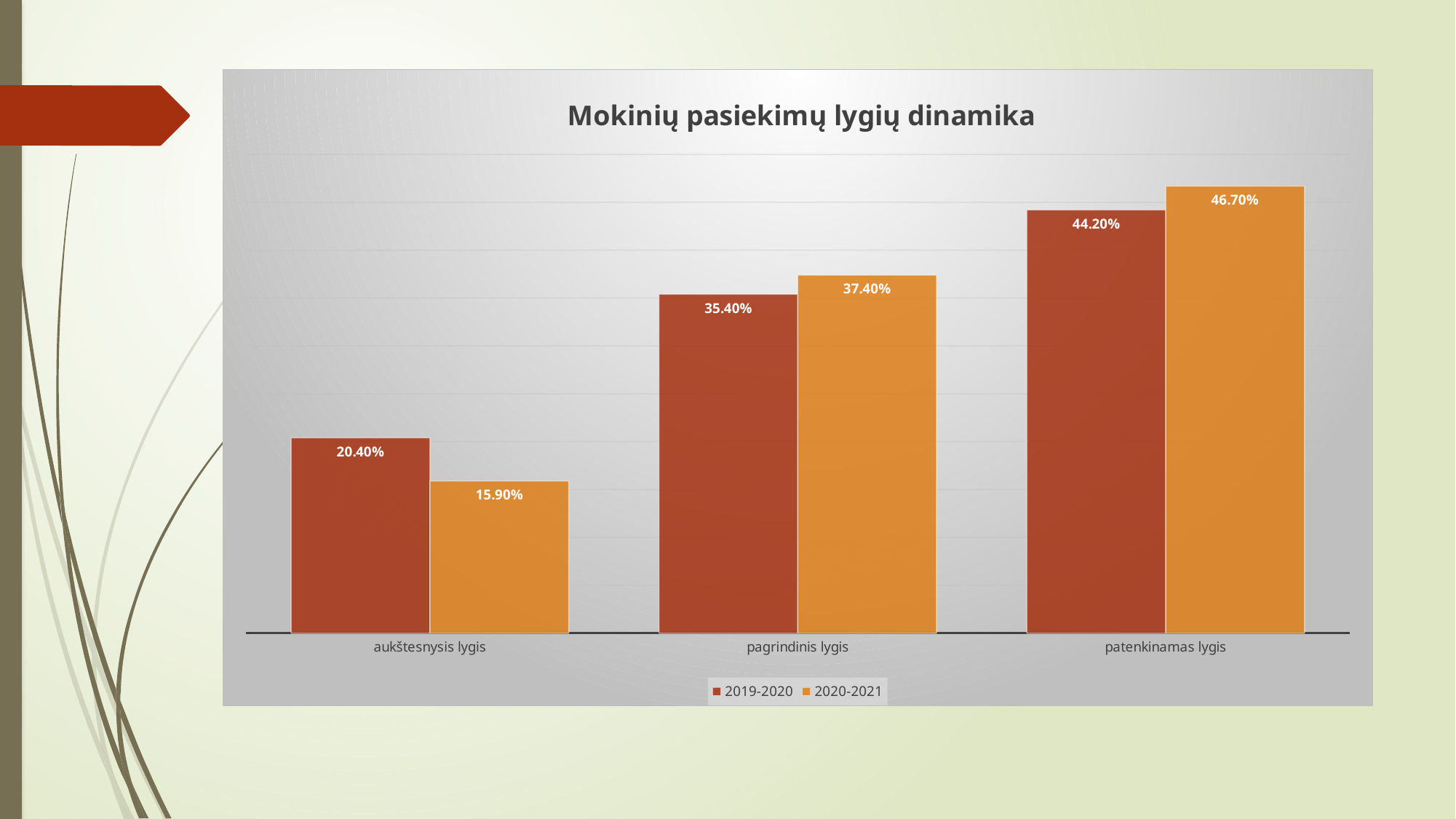
What is the value for pagrindinis lygis in the 2020-2021 series? 37.40% Which category has the highest value in the 2020-2021 series? patenkinamas lygis For pagrindinis lygis, which series has the larger value, 2019-2020 or 2020-2021? 2020-2021 What is the difference between the 2020-2021 and 2019-2020 values for patenkinamas lygis? 2.50% Which category has the lowest value in the 2019-2020 series? aukštesnysis lygis What is the difference between the 2019-2020 and 2020-2021 values for aukštesnysis lygis? 4.50% What is the value for aukštesnysis lygis in the 2019-2020 series? 20.40% How many series does the legend list? 2 How many categories are shown on the x axis? 3 What kind of chart is shown on the slide? bar chart What is the value for patenkinamas lygis in the 2019-2020 series? 44.20% What is the title of the chart? Mokinių pasiekimų lygių dinamika